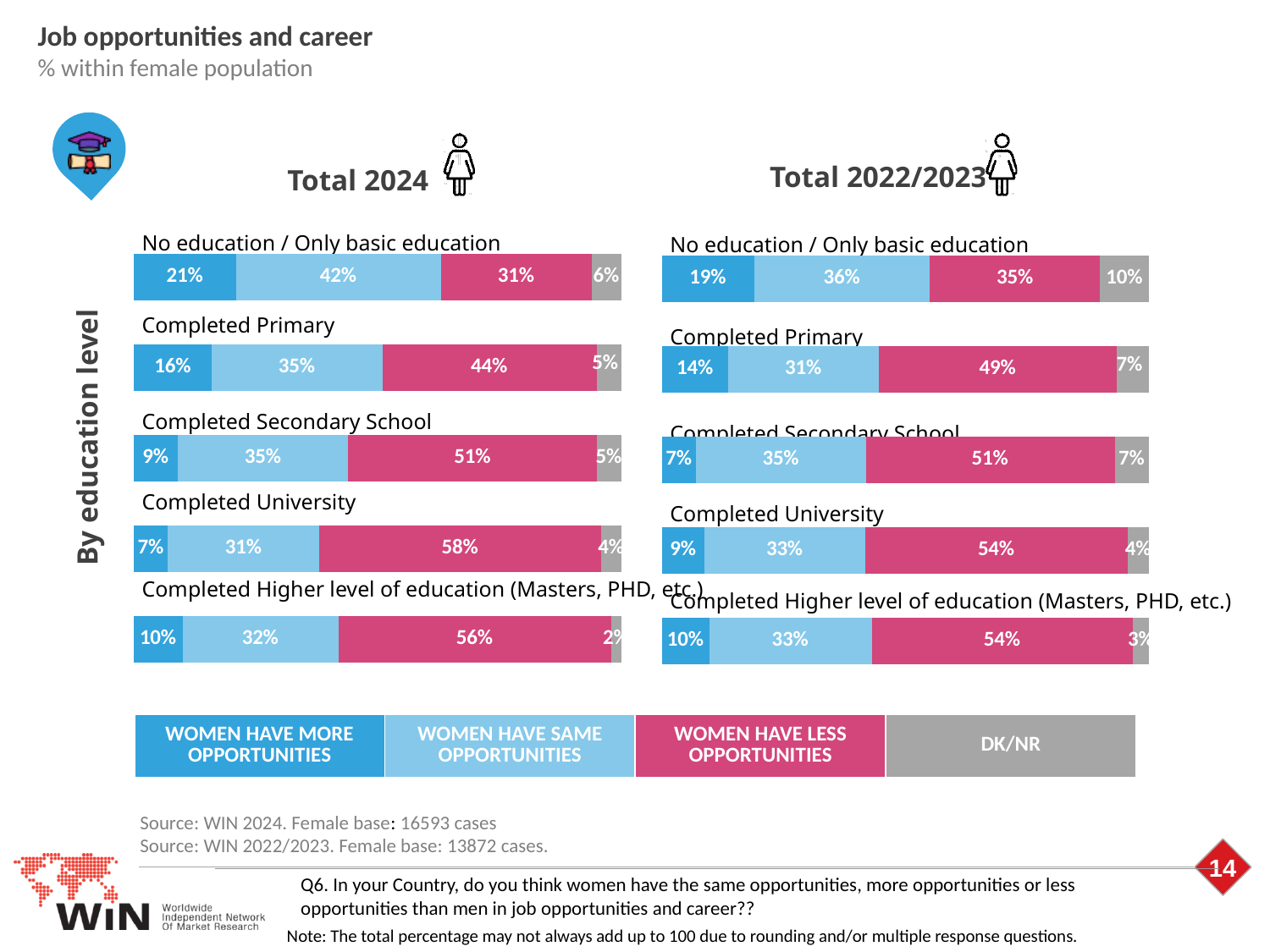
In the Total 2022/2023 chart, what percentage of women who completed secondary school say women have the same opportunities? 35% In the Total 2024 chart, which education level has the highest share saying women have more opportunities? No education / Only basic education In the Total 2024 chart, what is the total of the segments for No education / Only basic education? 100% For Completed University, is the 'women have less opportunities' share larger in the Total 2024 chart or the Total 2022/2023 chart? Total 2024 What kind of chart is used on this slide? Stacked bar chart How many response categories does the legend list? 4 How many education levels are shown in the Total 2024 chart? 5 In the Total 2022/2023 chart, what is the DK/NR value for No education / Only basic education? 10% In the Total 2022/2023 chart, which education level has the lowest share saying women have less opportunities? No education / Only basic education In the Total 2024 chart, what percentage of women who completed university say women have less opportunities? 58% Which colour represents 'Women have less opportunities' in the legend? Pink In the Total 2024 chart, for Completed Primary, how many percentage points higher is 'women have less opportunities' than 'women have more opportunities'? 28 percentage points